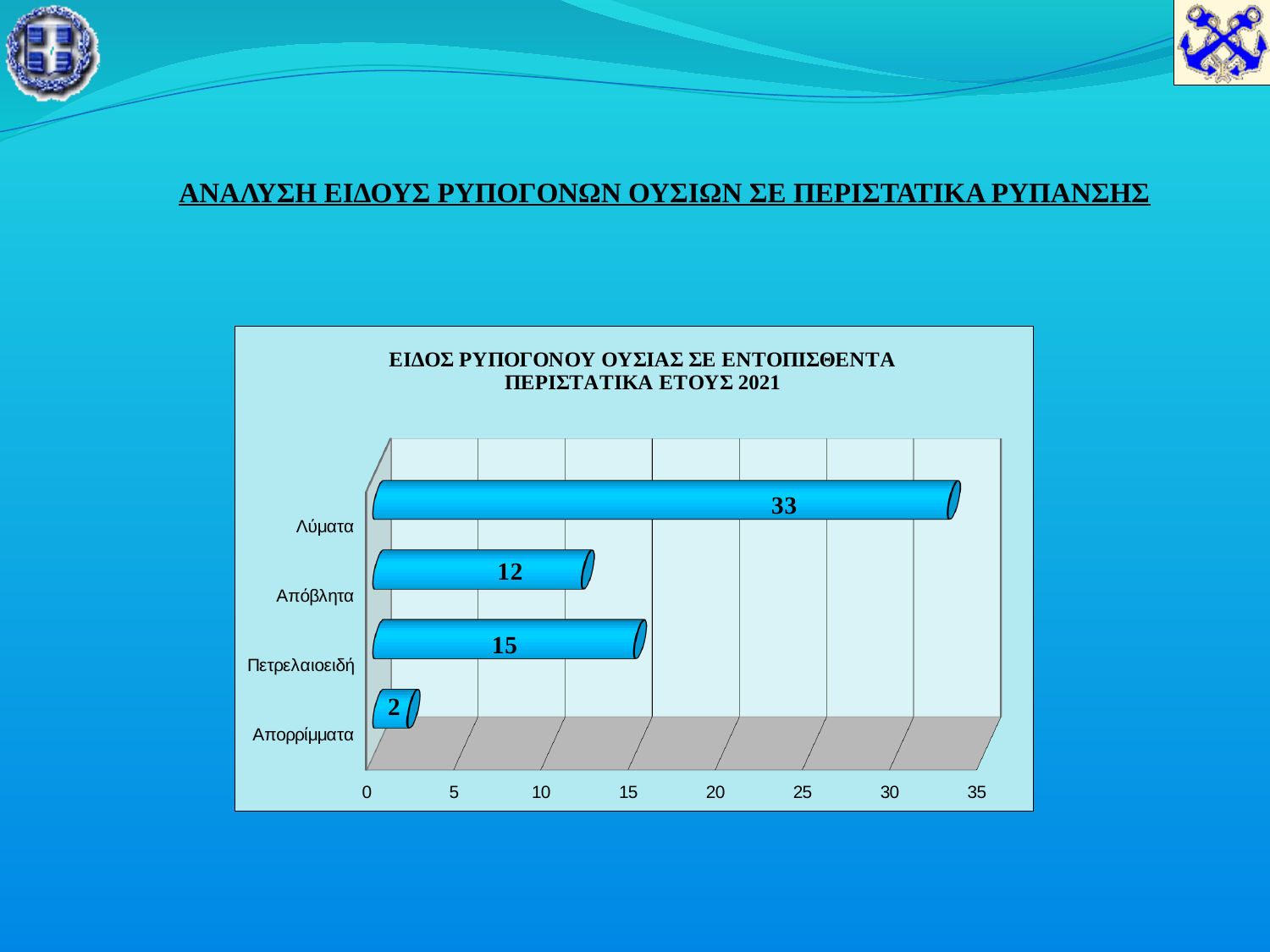
What is the value for Απόβλητα? 12 What is the difference between the values for Πετρελαιοειδή and Απόβλητα? 3 What is the value for Λύματα? 33 How many categories are shown in the chart? 4 Which category has the lowest value? Απορρίμματα Which category has the highest value? Λύματα What is the value for Απορρίμματα? 2 What is the value for Πετρελαιοειδή? 15 What is the difference between the values for Λύματα and Πετρελαιοειδή? 18 Which is larger, the value for Απόβλητα or the value for Πετρελαιοειδή? Πετρελαιοειδή What kind of chart is shown on the slide? Bar chart What year does the chart title refer to? 2021